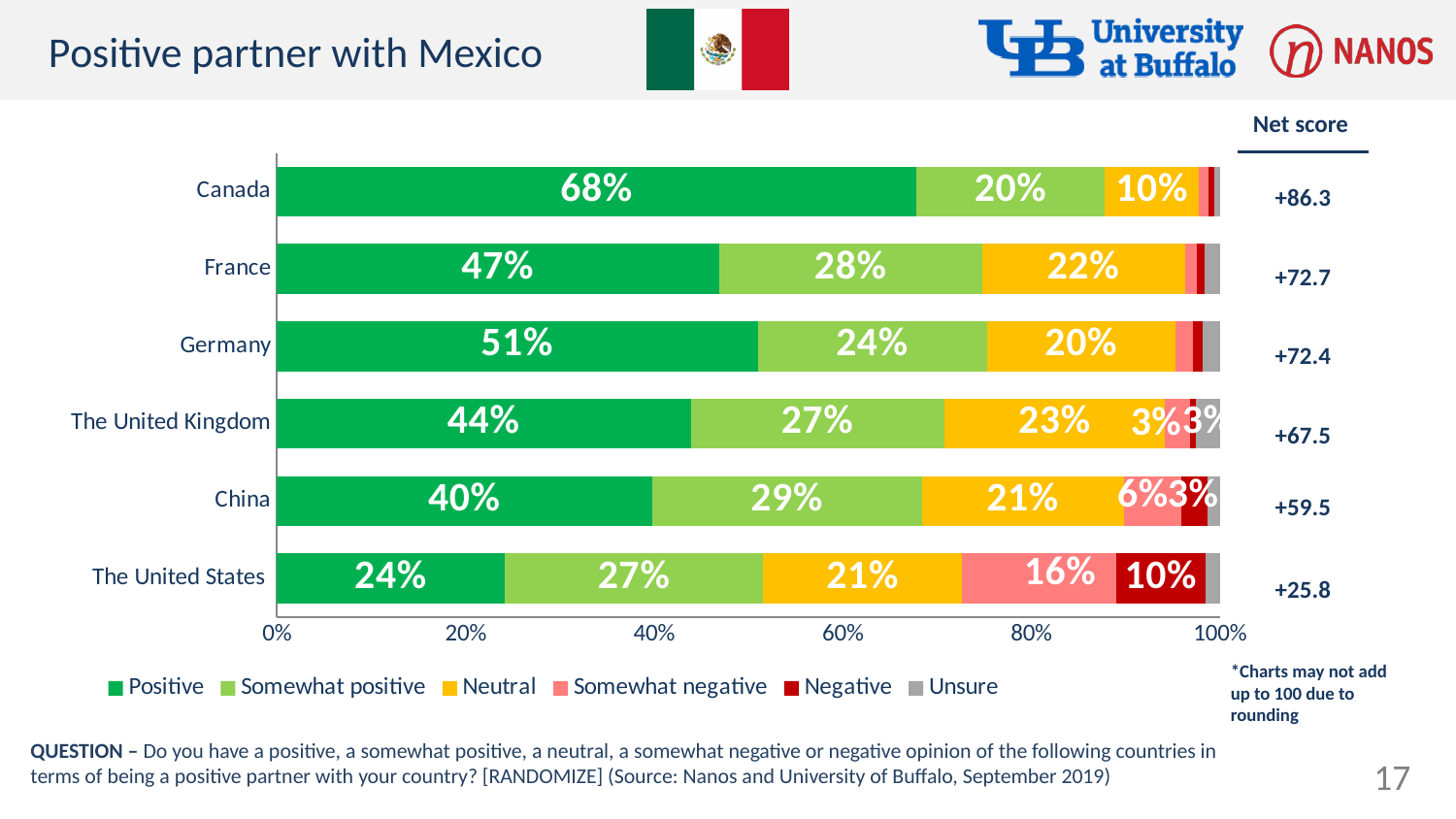
What kind of chart is shown on the slide? Stacked bar chart How many countries are shown in the chart? 6 Is the Positive value for The United States greater or less than 40%? less Which country has the highest Positive value? Canada What is the Somewhat positive value for China? 29% What is the difference between the Positive values for Canada and France? 21% Which country has the lowest Positive value? The United States What is the Somewhat negative value for The United States? 16% What percentage of respondents have a Positive opinion of Canada? 68% Which has a larger Somewhat positive value, France or Germany? France How many series does the legend list? 6 What is the Neutral value for France? 22%